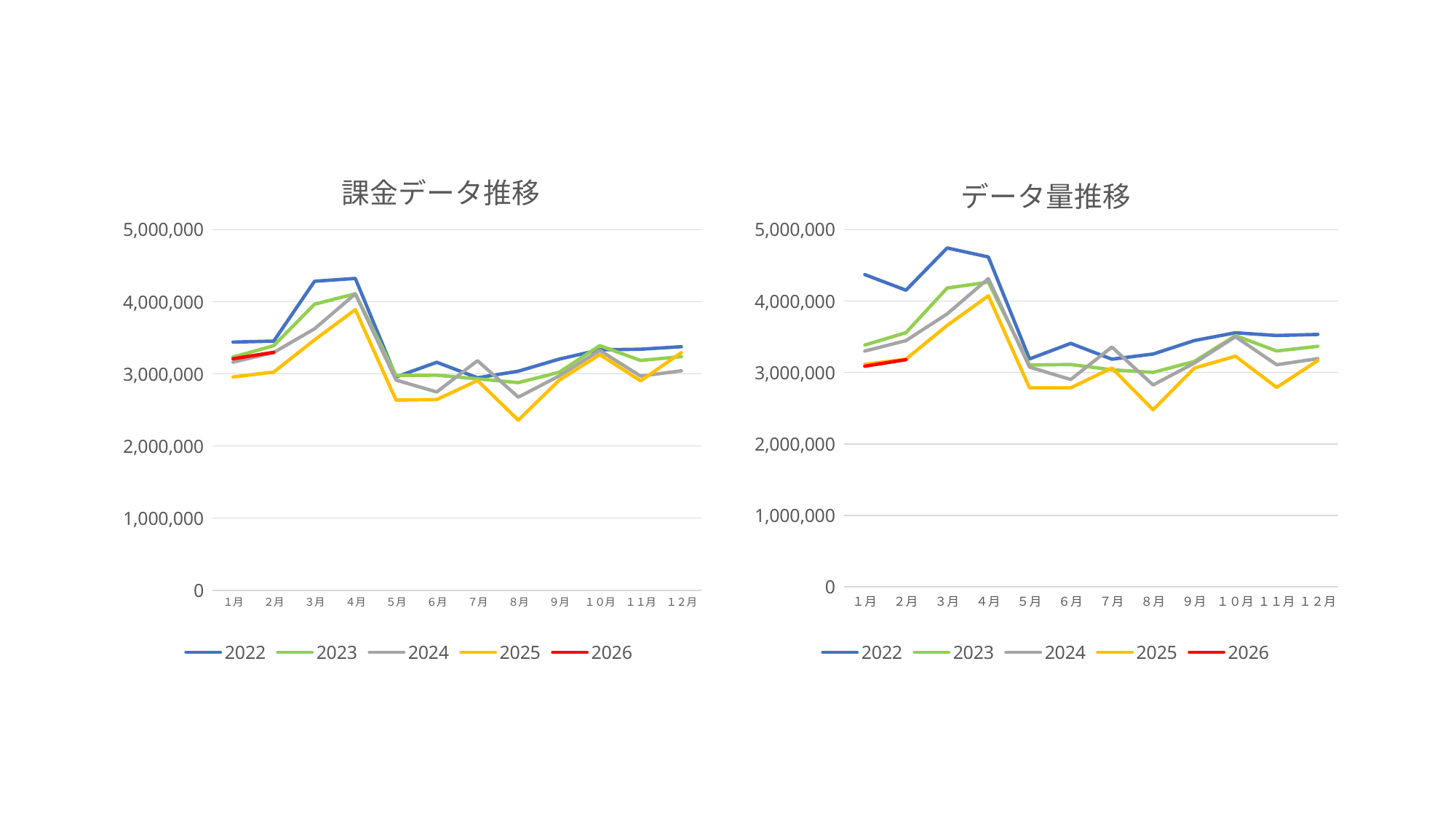
How many categories are on the x axis of the chart titled 課金データ推移? 12 In the chart titled 課金データ推移, is the value for 2025 in 8月 greater or less than 3,000,000? less In the chart titled データ量推移, is the value for 2022 in 3月 greater or less than 4,000,000? greater In the chart titled データ量推移, which is larger in 5月: the value for 2022 or the value for 2025? 2022 In the chart titled 課金データ推移, is the value for 2022 in 4月 greater or less than 4,000,000? greater What kind of chart is the chart titled 課金データ推移? line chart Which series is drawn in red in the chart titled データ量推移? 2026 In the chart titled データ量推移, which series has the highest value in 1月? 2022 In the chart titled 課金データ推移, does the 2025 series rise or fall from 4月 to 5月? fall In the chart titled 課金データ推移, which series has the lowest value in 8月? 2025 How many series does the legend of the chart titled データ量推移 list? 5